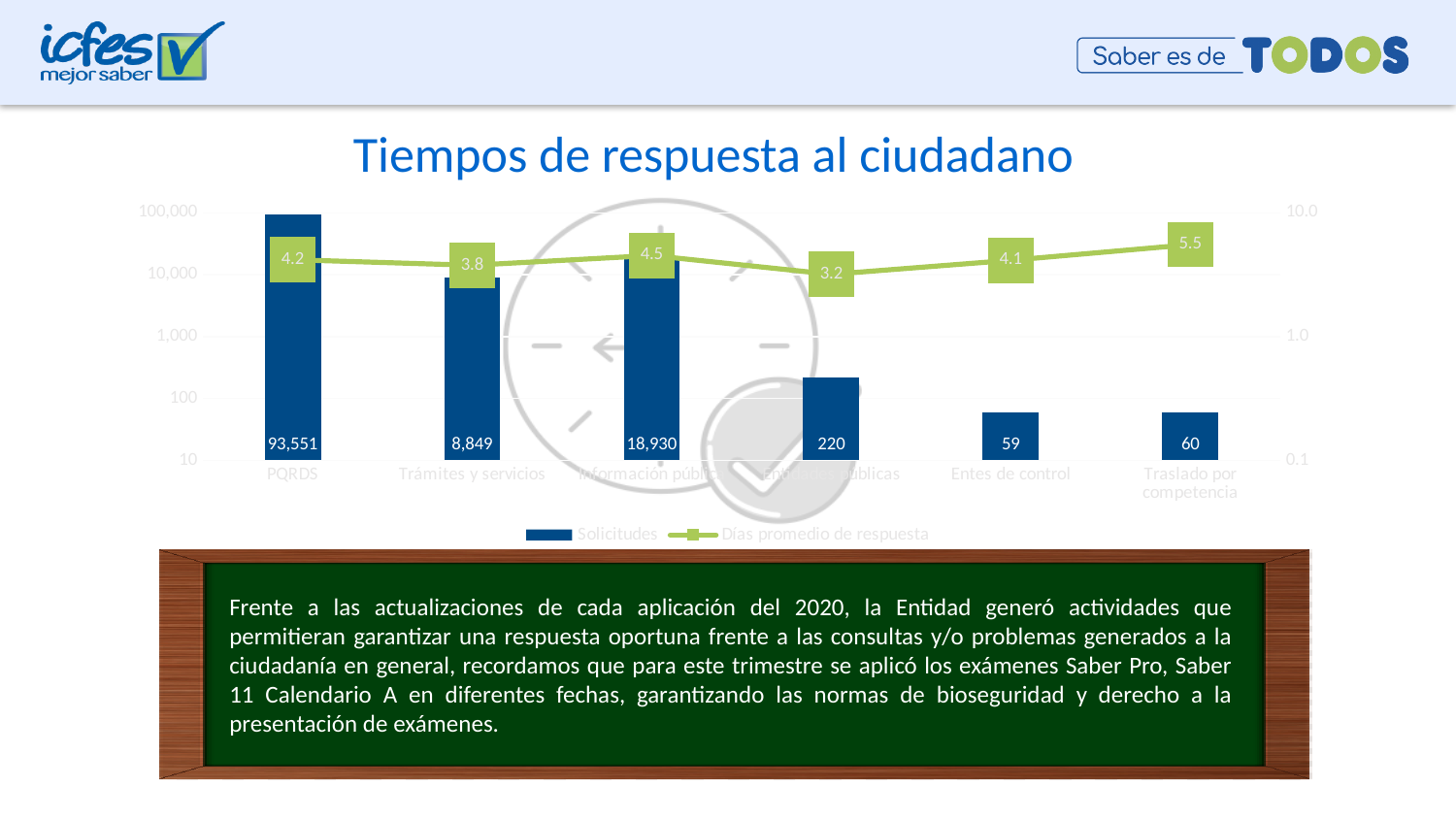
What is the Días promedio de respuesta value for Entes de control? 4.1 Which category has the highest Días promedio de respuesta value? Traslado por competencia Which category has the highest Solicitudes value? PQRDS How many series does the chart legend list? 2 How many categories are shown on the x axis of the chart? 6 What is the Solicitudes value for Entes de control? 59 Which has a higher Días promedio de respuesta, PQRDS or Trámites y servicios? PQRDS What is the title of the chart? Tiempos de respuesta al ciudadano What is the Días promedio de respuesta value for Traslado por competencia? 5.5 What is the difference in Solicitudes between PQRDS and Trámites y servicios? 84,702 Which category has the lowest Solicitudes value? Entes de control What is the Solicitudes value for PQRDS? 93,551